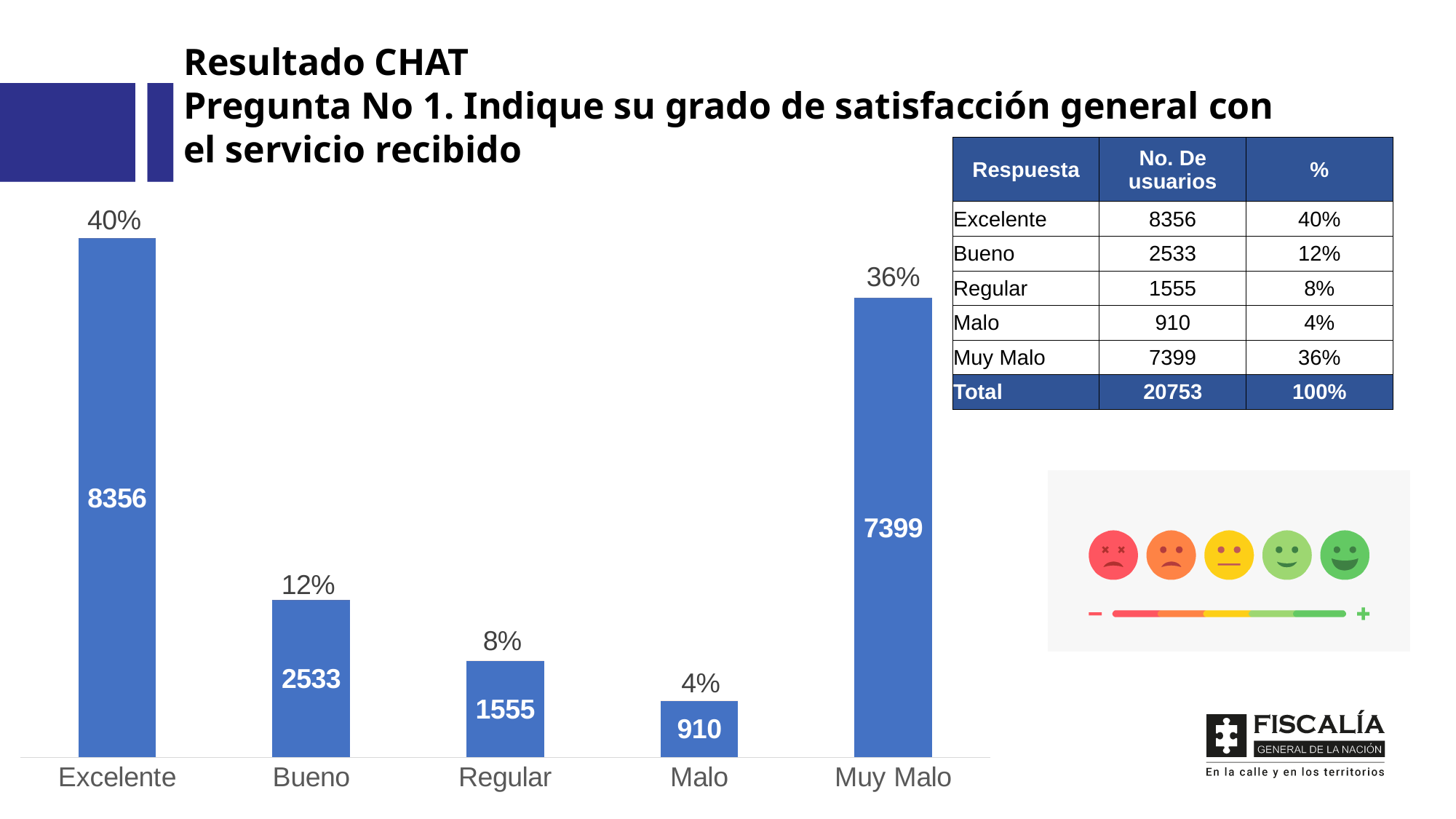
What percentage is shown above the Bueno bar? 12% How many categories are shown on the x axis of the chart? 5 Which category has the highest number of users? Excelente Which has more users, Bueno or Malo? Bueno Which category has the lowest number of users? Malo What is the total number of users across all categories? 20753 What percentage is shown for Muy Malo? 36% What is the number of users for Regular? 1555 What is the number of users for Excelente? 8356 What is the difference in number of users between Excelente and Muy Malo? 957 What is the difference in number of users between Bueno and Regular? 978 What kind of chart is shown on the slide? Bar chart